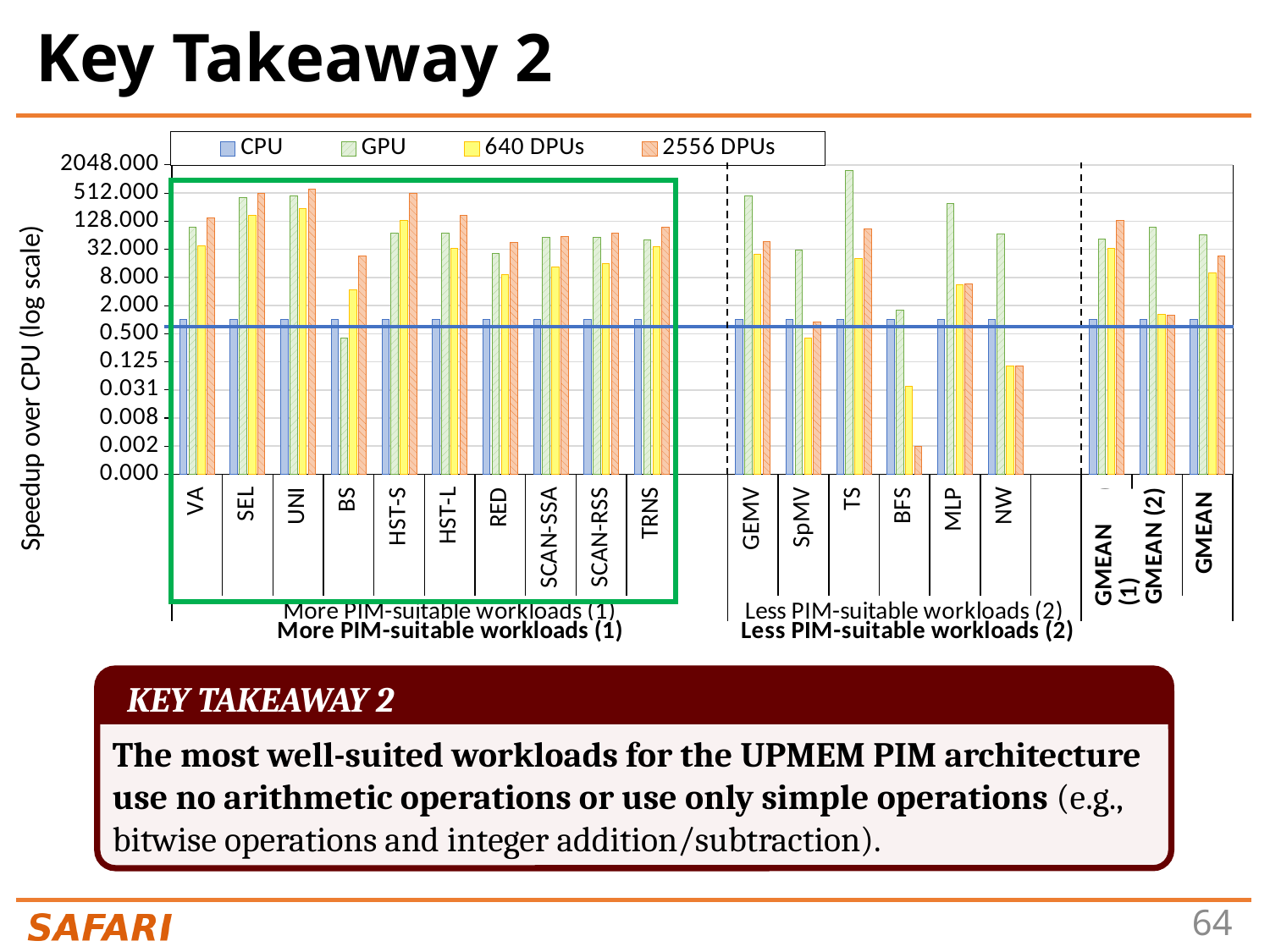
For TS, which is larger: the GPU value or the 2556 DPUs value? GPU How many workload categories are plotted along the x axis of the chart? 19 What is the label of the y axis of the chart? Speedup over CPU (log scale) Is the 2556 DPUs value for BFS greater or less than 0.031? less Is the 2556 DPUs value for UNI greater or less than 128.000? greater What kind of chart is shown on the slide? bar chart Is the GPU value for TS greater or less than 512.000? greater Which workload has the lowest 2556 DPUs bar in the chart? BFS Which workload has the highest GPU bar in the chart? TS How many series does the chart legend list? 4 Which series in the legend is drawn in yellow? 640 DPUs